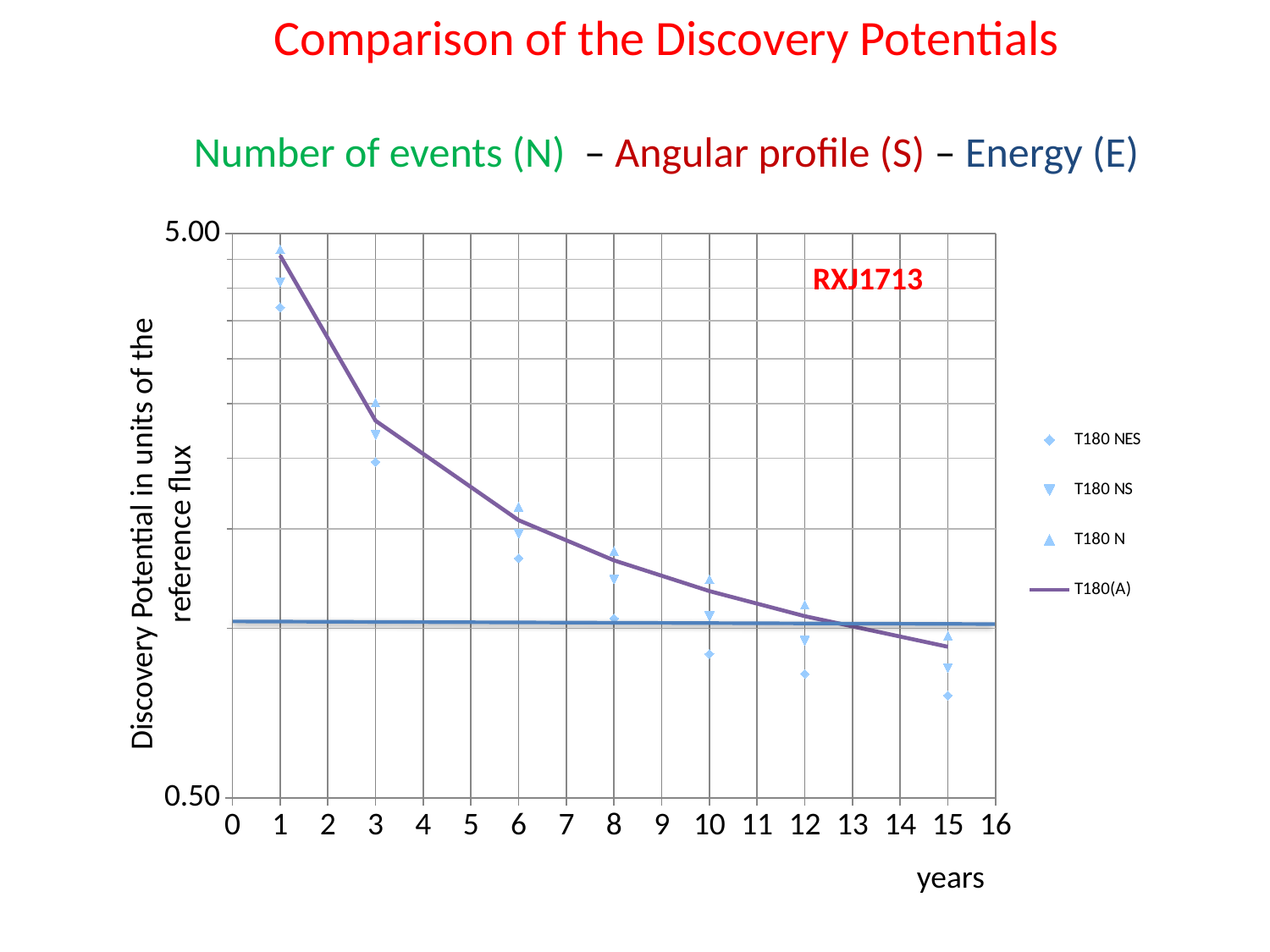
Is the T180(A) value at year 1 greater or less than 0.50? greater What are the series names listed in the chart legend? T180 NES, T180 NS, T180 N, T180(A) How many data points are plotted for the T180 NES series? 7 At year 15, which is larger: the T180 N value or the T180 NES value? T180 N What is the label of the x axis? years Does the T180(A) line rise or fall as the number of years increases? fall At year 1, which is larger: the T180 N value or the T180 NES value? T180 N At which year is the T180 NES value lowest? 15 What is the highest value labelled on the y axis? 5.00 What kind of chart is shown on the slide? scatter chart At which year is the T180 N value highest? 1 How many series does the chart legend list? 4